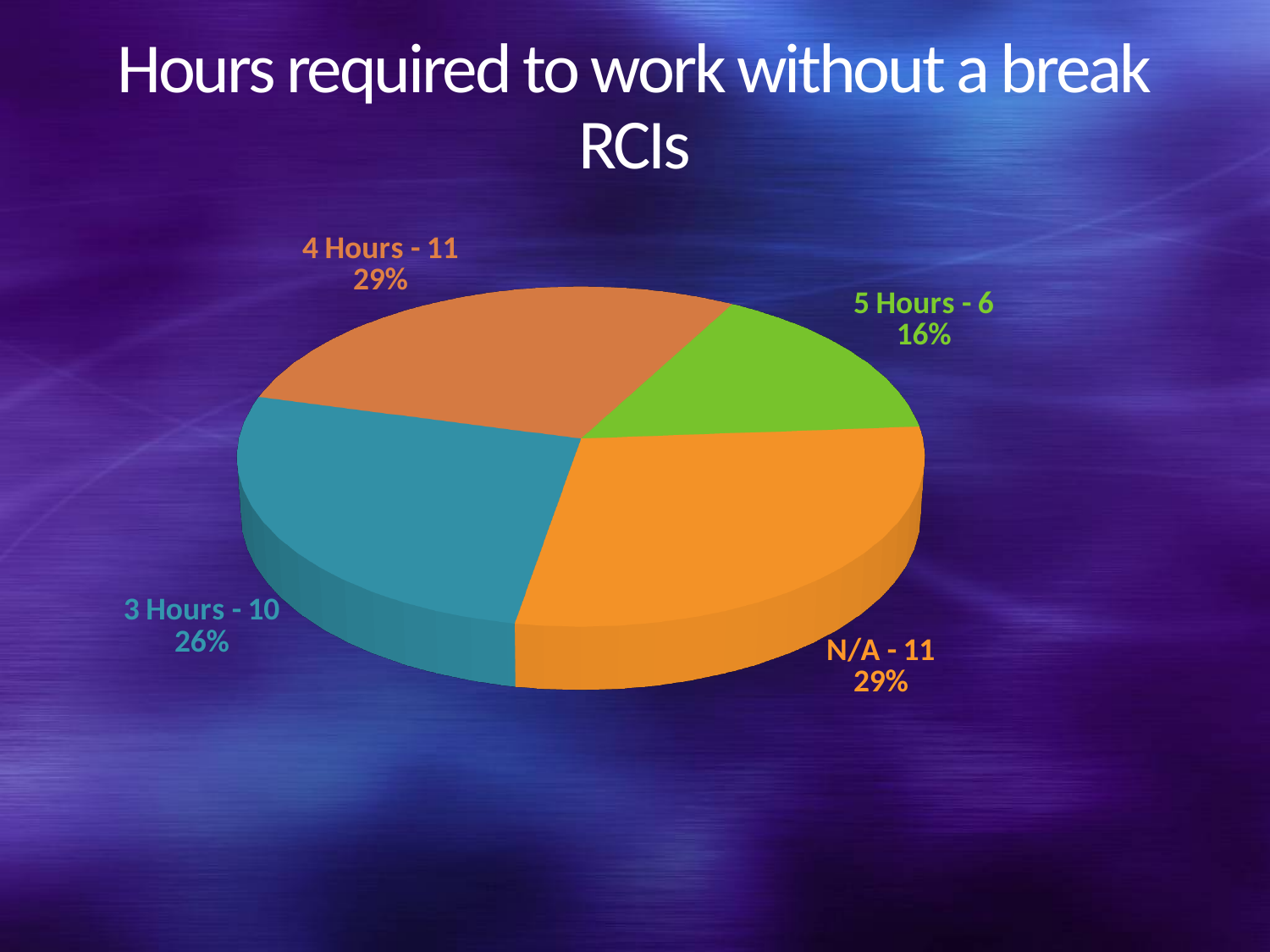
What is the title of the chart? Hours required to work without a break RCIs What is the difference between the count for 4 Hours and the count for 5 Hours? 5 What is the total of the counts across all slices? 38 Which is larger, the count for 3 Hours or the count for 5 Hours? 3 Hours What is the count for 3 Hours? 10 How many slices does the pie chart have? 4 What share of the pie does 3 Hours represent? 26% What share of the pie does 5 Hours represent? 16% What is the count for 5 Hours? 6 What kind of chart is shown on the slide? Pie chart What is the count for N/A? 11 Which category has the smallest slice? 5 Hours